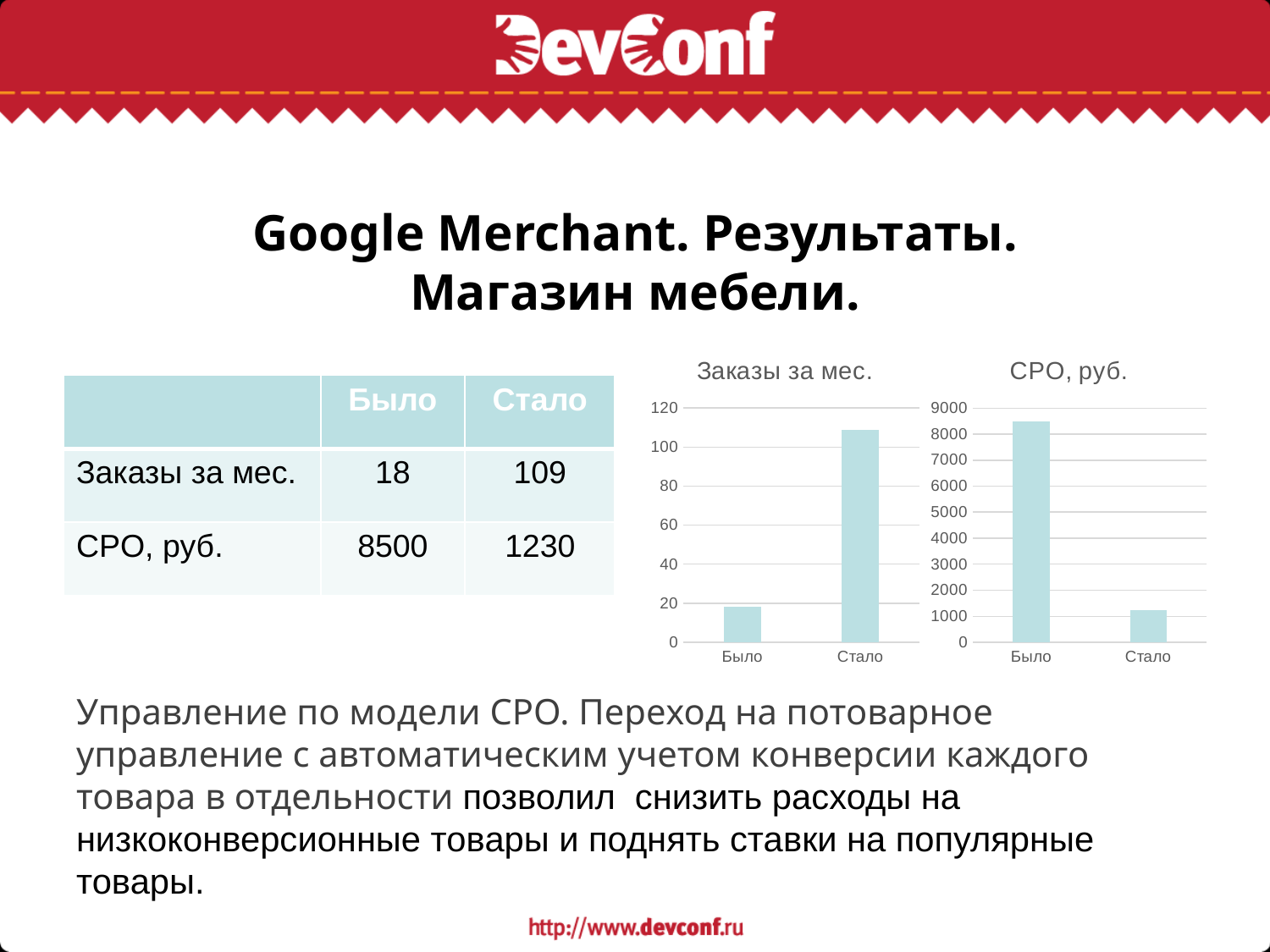
How many categories are shown in the chart titled "CPO, руб."? 2 In the chart titled "CPO, руб.", what is the difference between "Было" and "Стало"? 7270 In the chart titled "Заказы за мес.", what is the value for "Стало"? 109 What type of chart is the one titled "Заказы за мес."? bar chart In the chart titled "CPO, руб.", what is the value for "Стало"? 1230 In the chart titled "Заказы за мес.", which category has the higher value? Стало In the chart titled "Заказы за мес.", what is the difference between "Стало" and "Было"? 91 In the chart titled "CPO, руб.", is the value for "Было" greater or less than 8000? greater In the chart titled "CPO, руб.", which category has the lower value? Стало In the chart titled "CPO, руб.", what is the value for "Было"? 8500 In the chart titled "Заказы за мес.", is the value for "Было" greater or less than 20? less In the chart titled "Заказы за мес.", what is the value for "Было"? 18